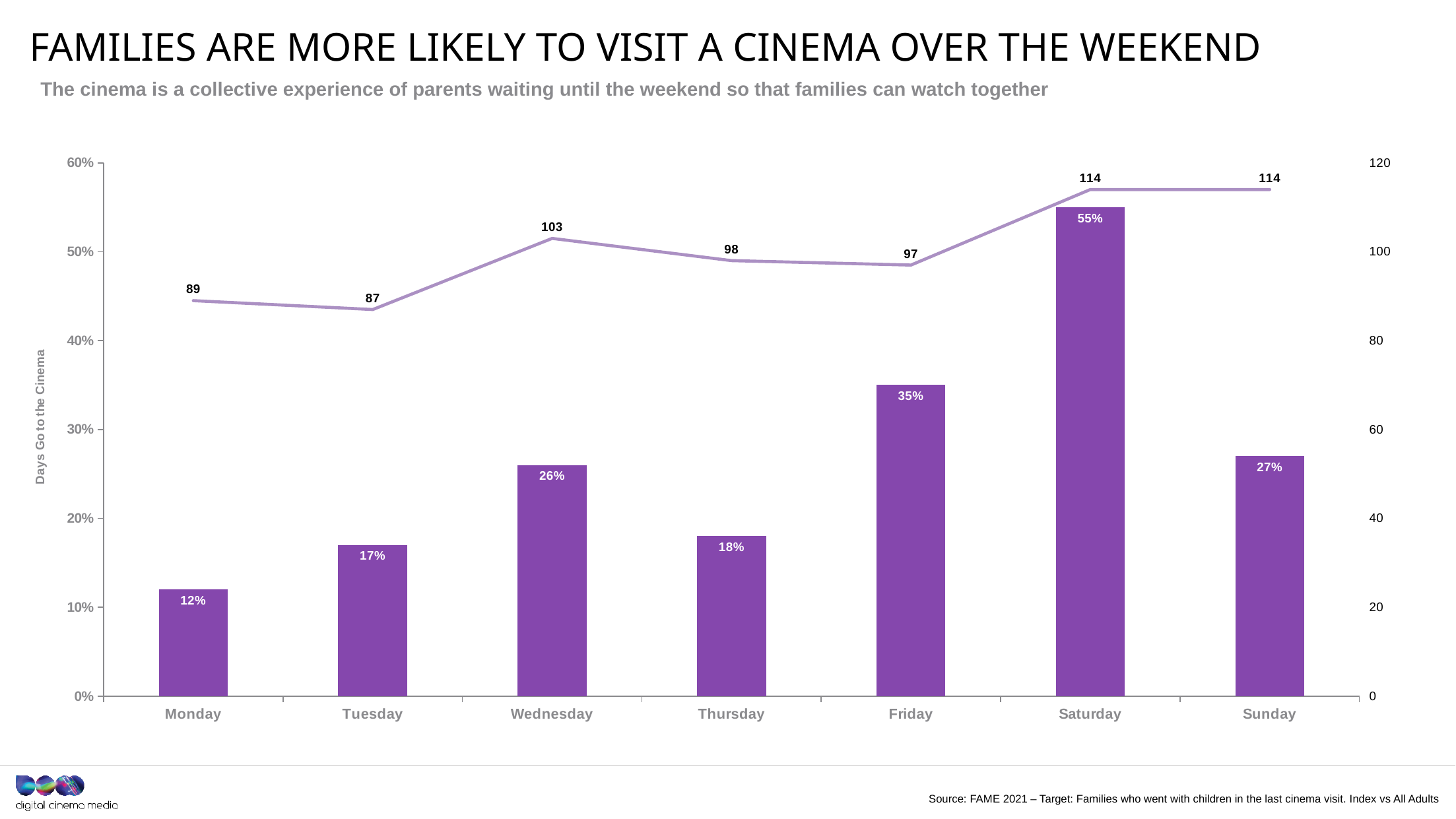
Which day has the lowest bar value? Monday What percentage is shown for Saturday in the bar series? 55% Which has the larger bar value, Wednesday or Sunday? Sunday Which day has the highest bar value? Saturday What is the index value shown on the line for Wednesday? 103 How many days are shown on the x axis? 7 What is the difference between the line values for Saturday and Friday? 17 What kind of chart is shown on the slide? A bar chart combined with a line chart Which day has the lowest index value on the line? Tuesday What percentage is shown for Thursday in the bar series? 18% What is the title of the left vertical axis? Days Go to the Cinema What is the difference between the bar values for Saturday and Friday? 20%